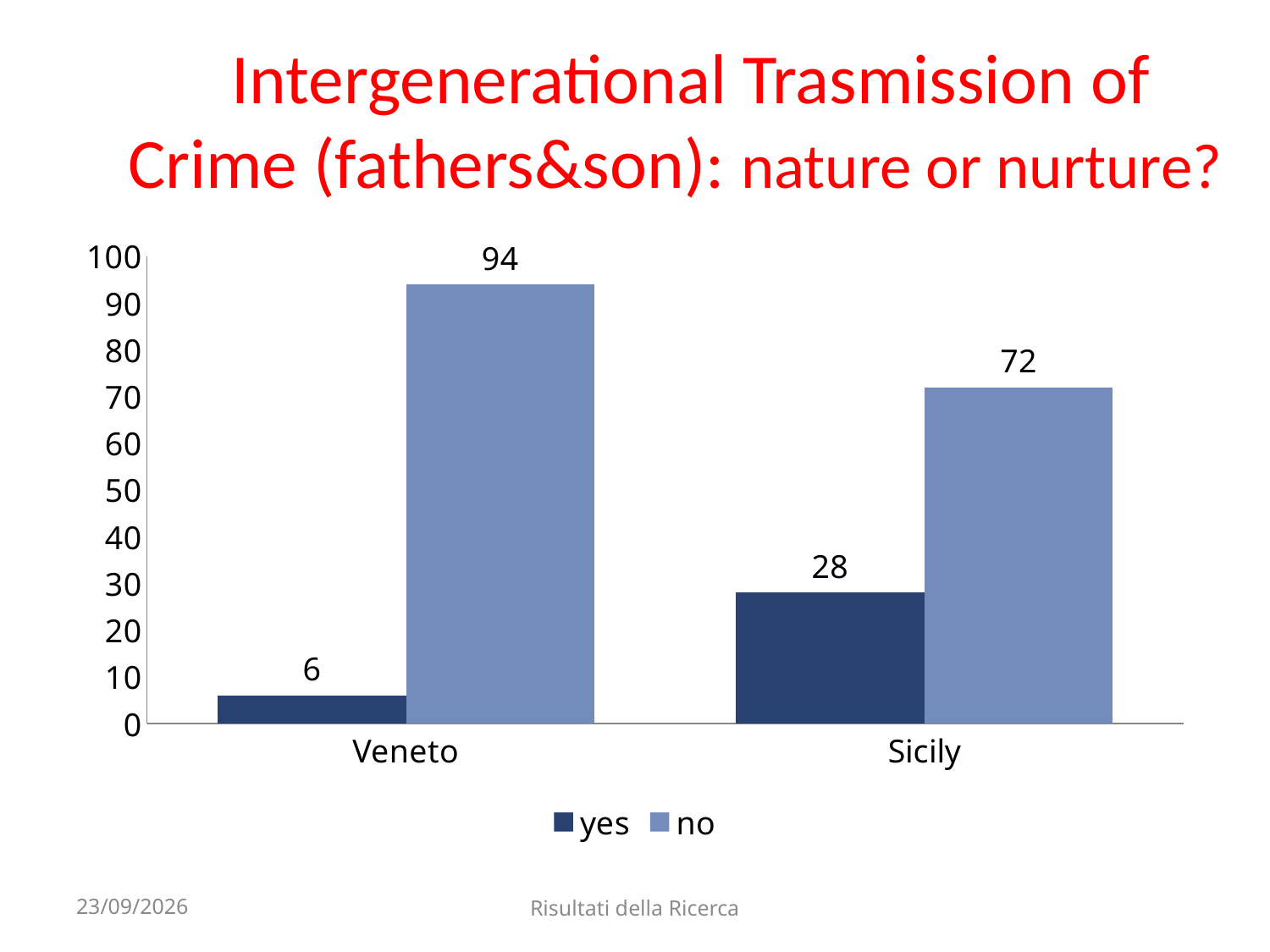
How many series does the legend list? 2 What is the difference between the "no" values for Veneto and Sicily? 22 Is the "yes" value for Sicily larger or smaller than the "yes" value for Veneto? larger What is the value for "no" in Sicily? 72 Which region has the lower "no" value? Sicily What kind of chart is shown on the slide? bar chart What is the difference between the "yes" values for Sicily and Veneto? 22 What is the value for "yes" in Sicily? 28 How many regions are shown on the x axis? 2 What is the value for "no" in Veneto? 94 What is the value for "yes" in Veneto? 6 Which region has the higher "yes" value? Sicily